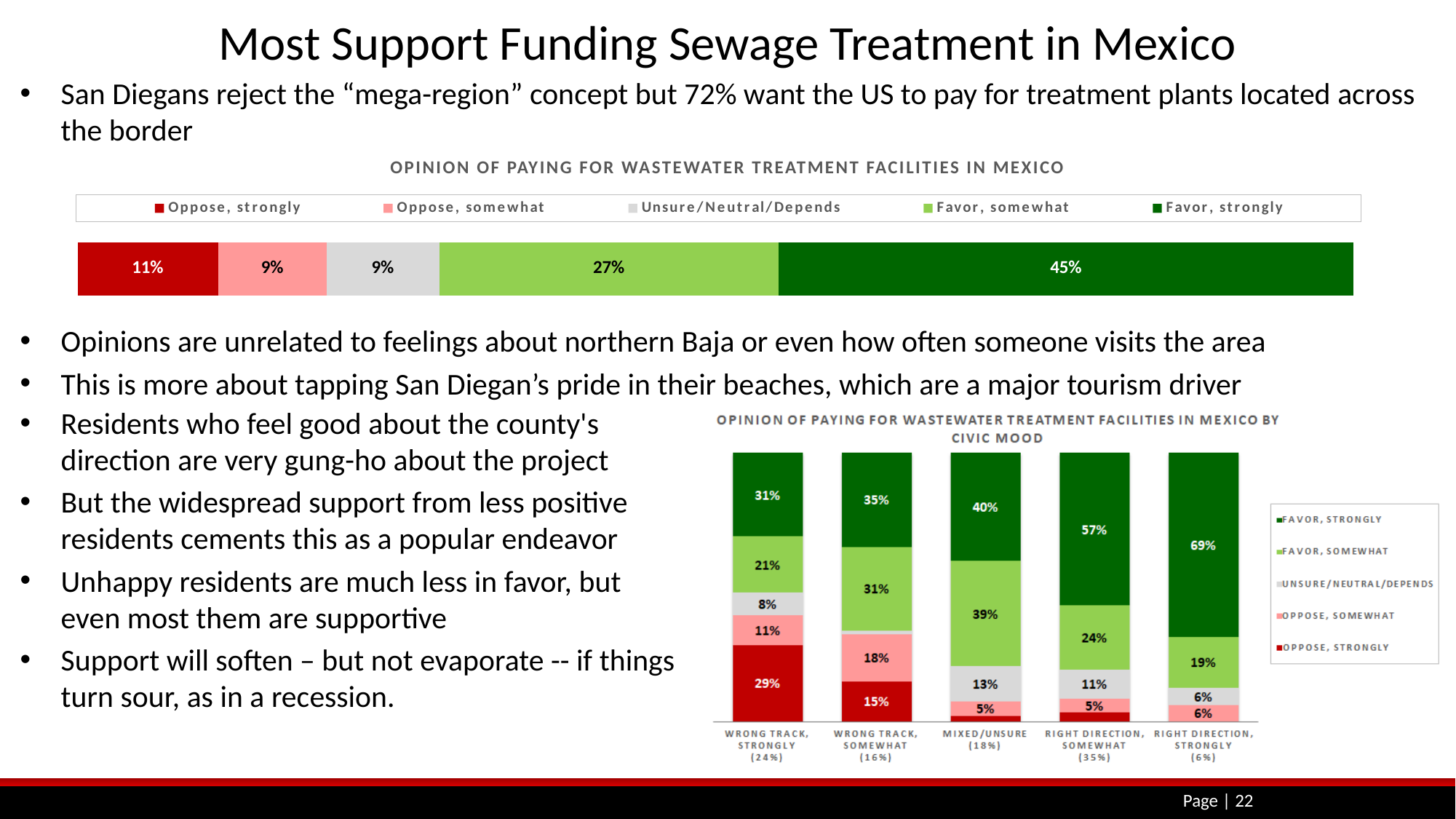
In the bottom chart, how many civic mood categories are shown on the x axis? 5 In the bottom chart, which civic mood group has the highest 'Favor, strongly' share? Right direction, strongly In the bottom chart, is the 'Favor, strongly' share larger for 'Mixed/unsure' or for 'Right direction, somewhat'? Right direction, somewhat In the bottom chart, what is the difference between the 'Favor, somewhat' shares of 'Mixed/unsure' and 'Right direction, strongly'? 20 percentage points In the bottom chart, what percentage of 'Wrong track, strongly' residents oppose strongly? 29% In the top chart, 'Opinion of Paying for Wastewater Treatment Facilities in Mexico', what percentage favor strongly? 45% What kind of chart is the bottom chart, 'Opinion of Paying for Wastewater Treatment Facilities in Mexico by Civic Mood'? Stacked bar chart In the top chart, what is the difference between the 'Favor, strongly' and 'Favor, somewhat' shares? 18 percentage points In the top chart, what percentage oppose strongly? 11% How many series does the legend of the top chart list? 5 In the bottom chart, what percentage of 'Right direction, strongly' residents favor strongly? 69% In the top chart, which response category has the largest share? Favor, strongly